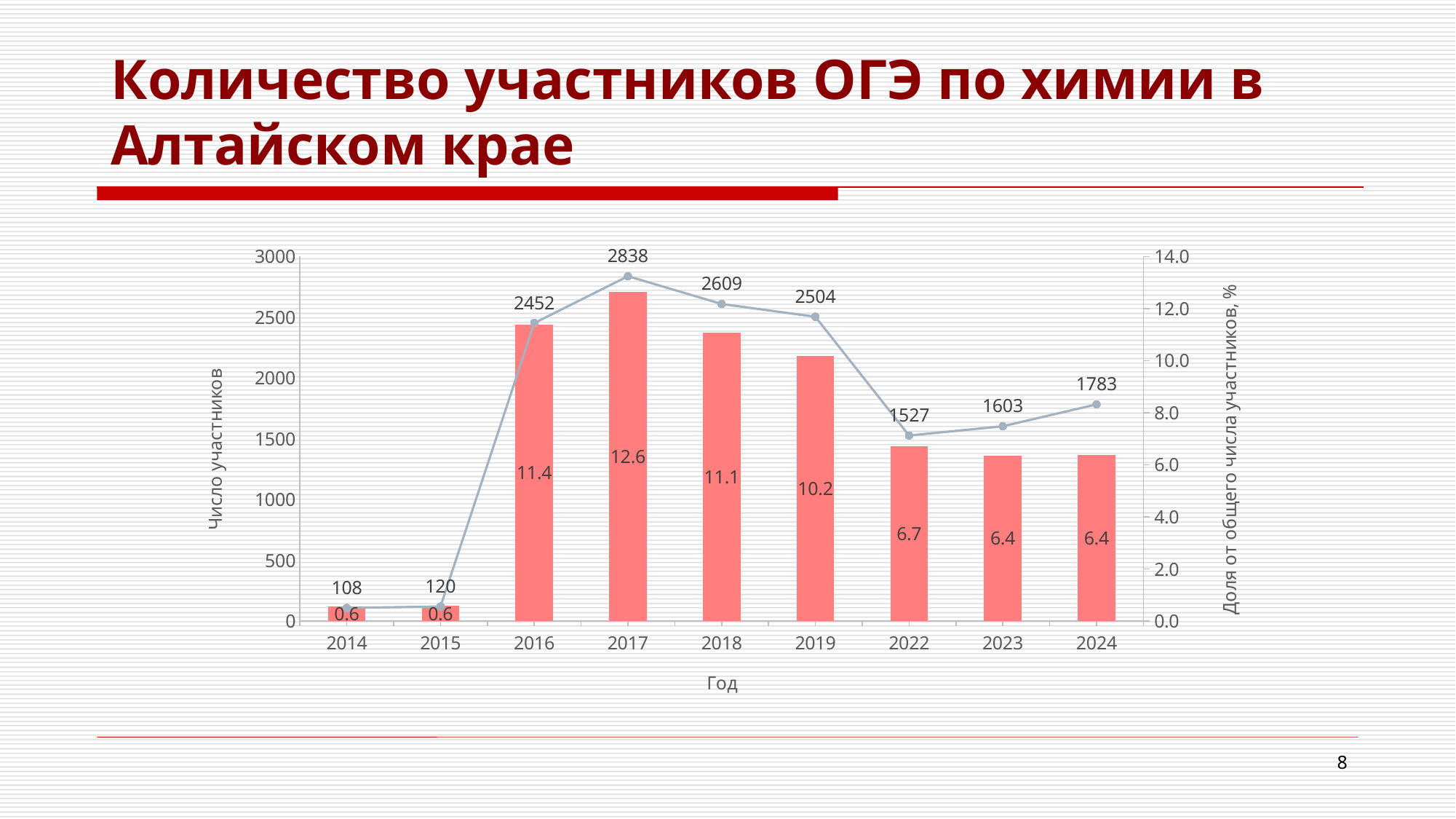
What is the difference between the number of participants in 2017 and in 2018? 229 What is the number of participants shown for 2014? 108 Does the number of participants rise or fall from 2022 to 2024? Rise Which year has the highest number of participants? 2017 Which year has the larger share of participants, 2016 or 2018? 2016 What is the number of participants shown for 2017? 2838 What is the label of the right vertical axis? Доля от общего числа участников, % Which year has the lowest number of participants? 2014 How many years are shown on the x axis? 9 What share of the total number of participants (%) is shown for 2019? 10.2 What is the difference between the number of participants in 2024 and in 2022? 256 What kind of chart is this? Combined bar and line chart